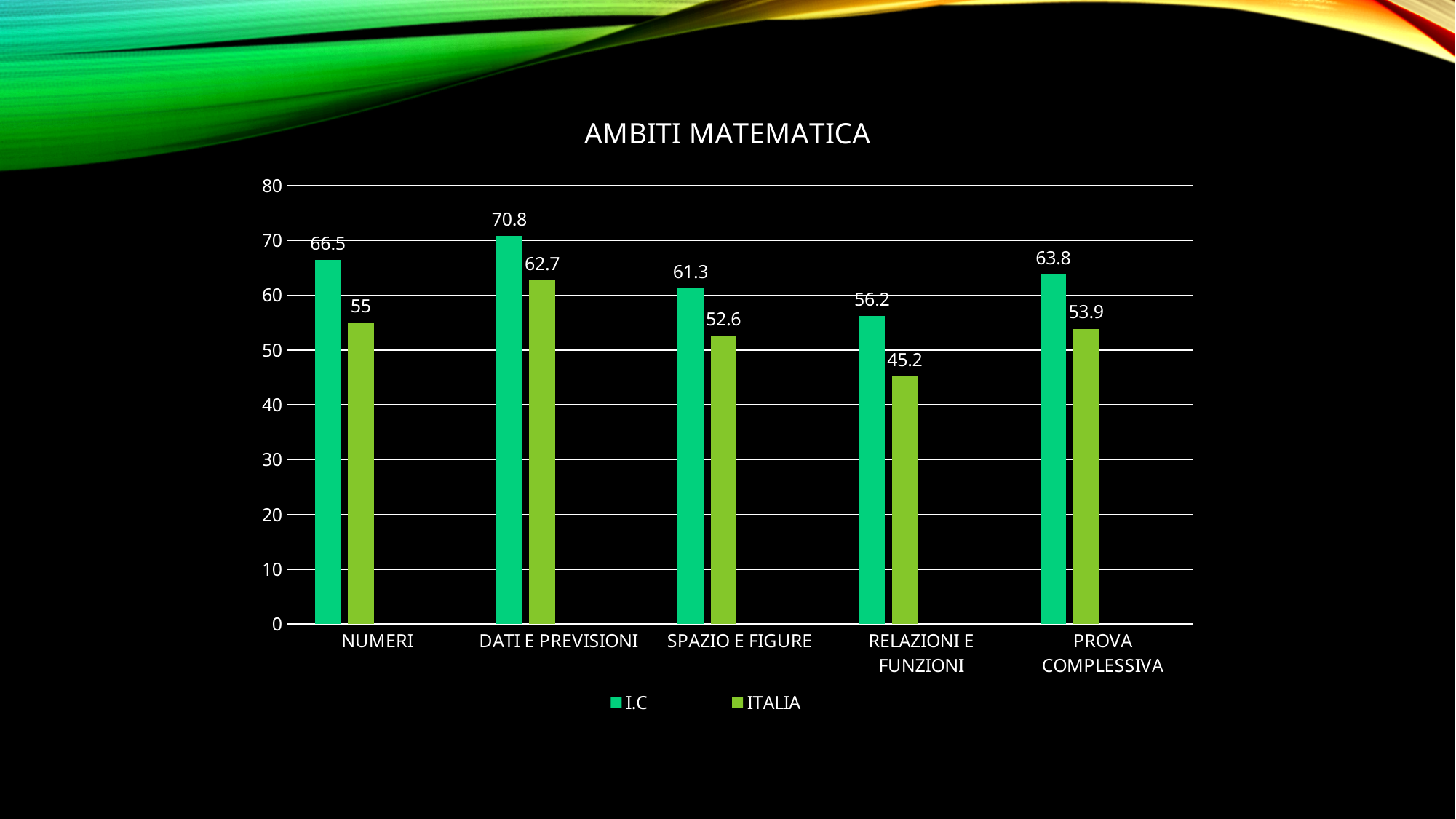
What is the ITALIA value for NUMERI? 55 What is the difference between the I.C and ITALIA values for SPAZIO E FIGURE? 8.7 What is the difference between the I.C and ITALIA values for PROVA COMPLESSIVA? 9.9 Which category has the lowest ITALIA value? RELAZIONI E FUNZIONI How many categories are shown on the x axis? 5 What is the ITALIA value for RELAZIONI E FUNZIONI? 45.2 How many series does the legend list? 2 Which is larger for NUMERI, the I.C value or the ITALIA value? I.C What kind of chart is shown on the slide? Bar chart Which category has the highest I.C value? DATI E PREVISIONI What is the title of the chart? AMBITI MATEMATICA What is the I.C value for DATI E PREVISIONI? 70.8